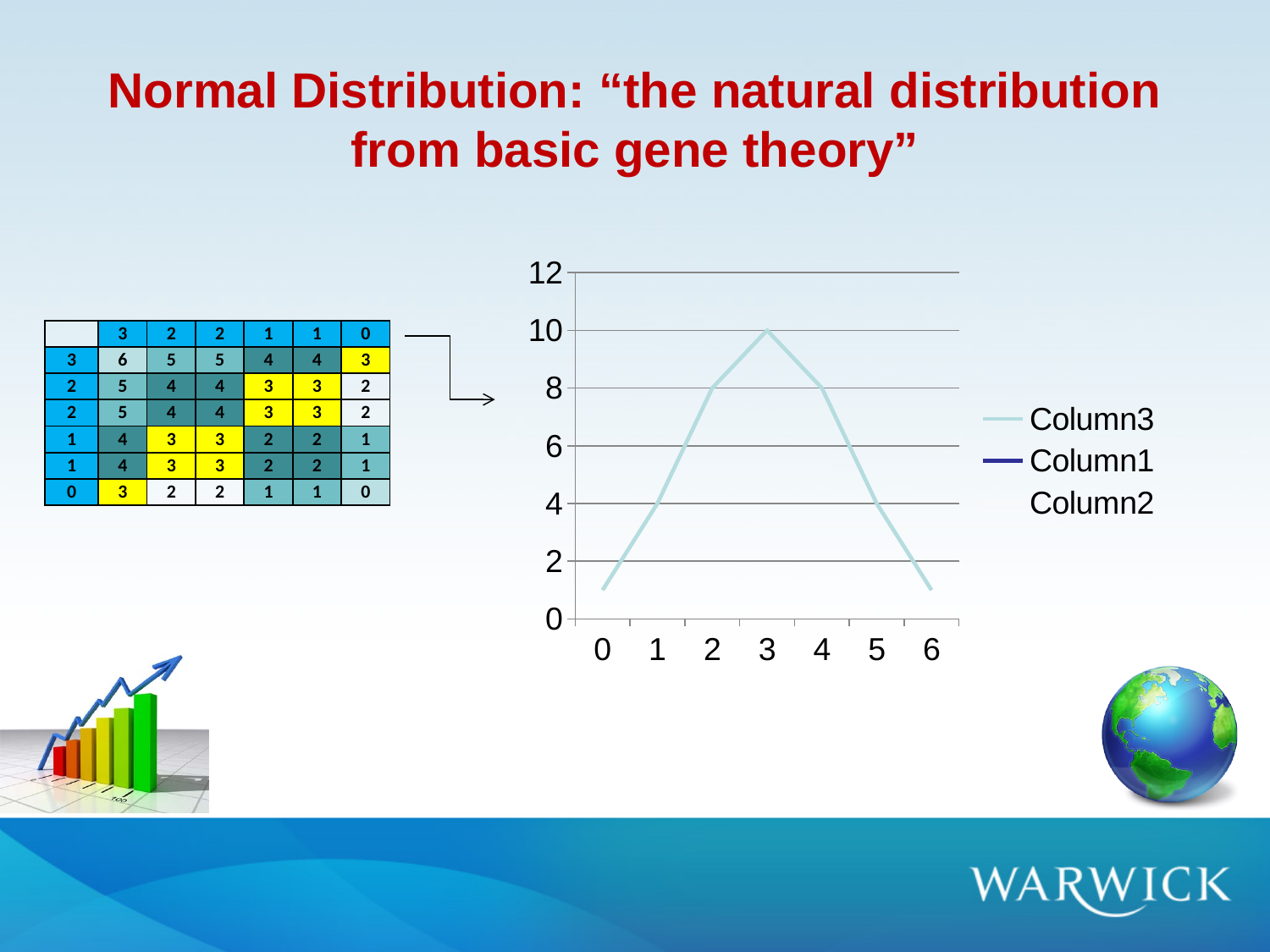
What is the value of the line at x = 2? 8 What kind of chart is shown on the slide? line chart What is the difference between the value at x = 3 and the value at x = 4? 2 What is the value of the line at x = 5? 4 Does the line rise or fall between x = 3 and x = 6? fall Is the value of the line at x = 6 greater or less than 2? less What is the value of the line at x = 3? 10 What are the names of the series listed in the chart's legend? Column3, Column1, Column2 Is the value of the line at x = 0 greater or less than 2? less At which x value does the line reach its highest point? 3 How many points are plotted along the x axis of the chart? 7 How many series does the chart's legend list? 3